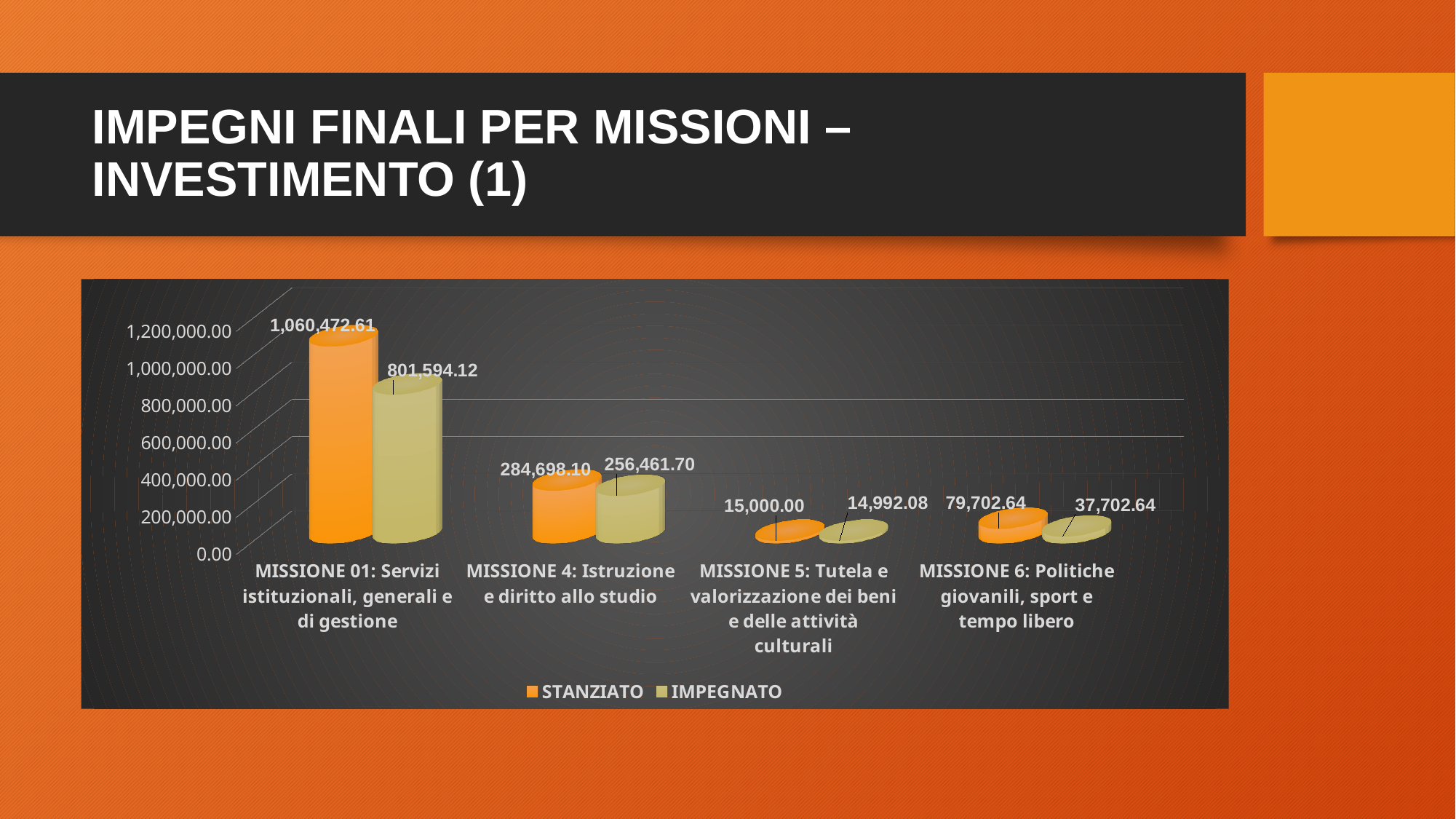
How many missions (categories) are shown on the x axis? 4 What is the STANZIATO value for MISSIONE 5: Tutela e valorizzazione dei beni e delle attività culturali? 15,000.00 What kind of chart is shown on the slide? Bar chart What is the difference between the STANZIATO and IMPEGNATO values for MISSIONE 01: Servizi istituzionali, generali e di gestione? 258,878.49 How many series does the legend list? 2 What is the IMPEGNATO value for MISSIONE 6: Politiche giovanili, sport e tempo libero? 37,702.64 Which is larger for MISSIONE 4: Istruzione e diritto allo studio, the STANZIATO value or the IMPEGNATO value? STANZIATO Which mission has the lowest IMPEGNATO value? MISSIONE 5: Tutela e valorizzazione dei beni e delle attività culturali Which mission has the highest STANZIATO value? MISSIONE 01: Servizi istituzionali, generali e di gestione What is the STANZIATO value for MISSIONE 01: Servizi istituzionali, generali e di gestione? 1,060,472.61 What is the difference between the STANZIATO and IMPEGNATO values for MISSIONE 6: Politiche giovanili, sport e tempo libero? 42,000.00 What is the IMPEGNATO value for MISSIONE 4: Istruzione e diritto allo studio? 256,461.70